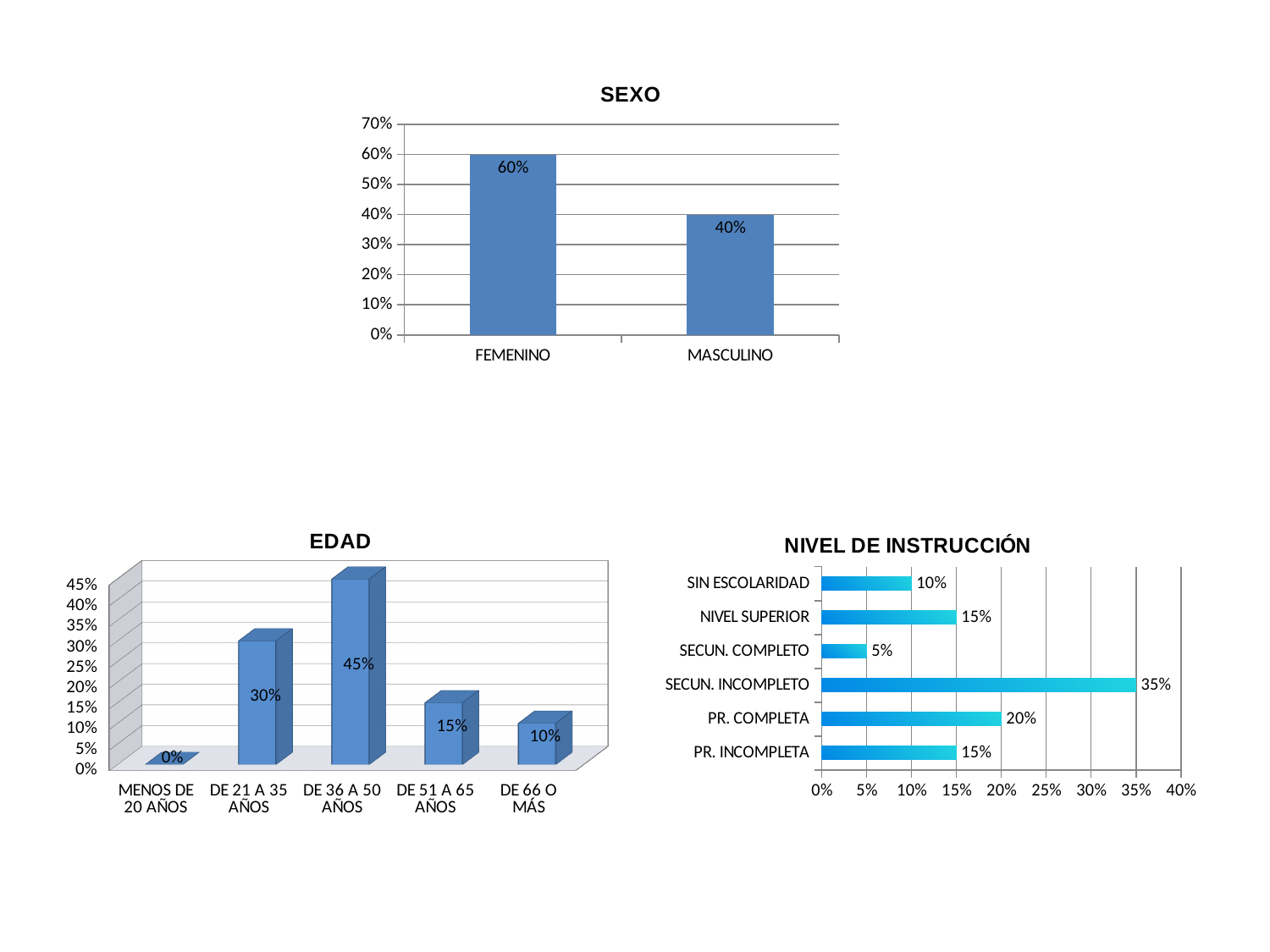
In the EDAD chart, how many categories are shown? 5 In the NIVEL DE INSTRUCCIÓN chart, what is the difference between PR. COMPLETA and PR. INCOMPLETA? 5% In the NIVEL DE INSTRUCCIÓN chart, what is the value for SECUN. INCOMPLETO? 35% In the NIVEL DE INSTRUCCIÓN chart, which category has the lowest value? SECUN. COMPLETO In the EDAD chart, which category has the lowest value? MENOS DE 20 AÑOS In the EDAD chart, what is the value for DE 36 A 50 AÑOS? 45% What kind of chart is the NIVEL DE INSTRUCCIÓN chart? Bar chart In the EDAD chart, which category has the highest value? DE 36 A 50 AÑOS In the EDAD chart, which is larger, DE 21 A 35 AÑOS or DE 51 A 65 AÑOS? DE 21 A 35 AÑOS In the SEXO chart, what is the difference between FEMENINO and MASCULINO? 20% In the SEXO chart, what is the value for FEMENINO? 60% In the SEXO chart, how many categories are shown? 2